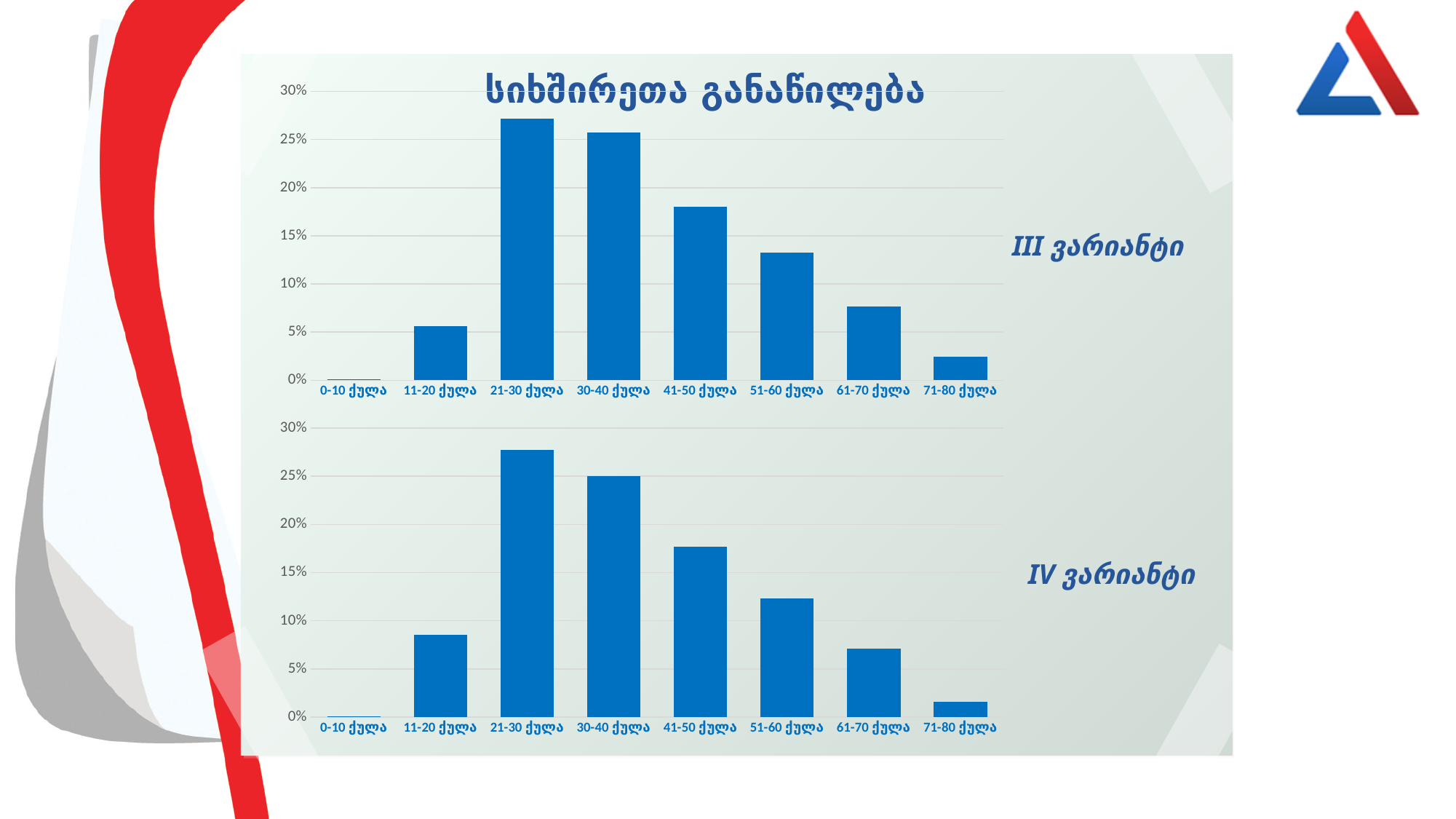
In the bottom chart (IV ვარიანტი), which category has the highest value? 21-30 ქულა In the top chart (III ვარიანტი), which is larger: the value for 41-50 ქულა or 51-60 ქულა? 41-50 ქულა What kind of chart is the top chart (III ვარიანტი)? bar chart In the bottom chart (IV ვარიანტი), is the value for 11-20 ქულა greater or less than 5%? greater What is the title shown above the top chart? სიხშირეთა განაწილება In the top chart (III ვარიანტი), which category has the highest value? 21-30 ქულა In the bottom chart (IV ვარიანტი), is the value for 51-60 ქულა greater or less than 10%? greater In the top chart (III ვარიანტი), which category has the lowest value? 0-10 ქულა In the bottom chart (IV ვარიანტი), do the values rise or fall from 21-30 ქულა to 71-80 ქულა? fall In the top chart (III ვარიანტი), is the value for 71-80 ქულა greater or less than 5%? less How many score categories are shown on the x axis of the bottom chart (IV ვარიანტი)? 8